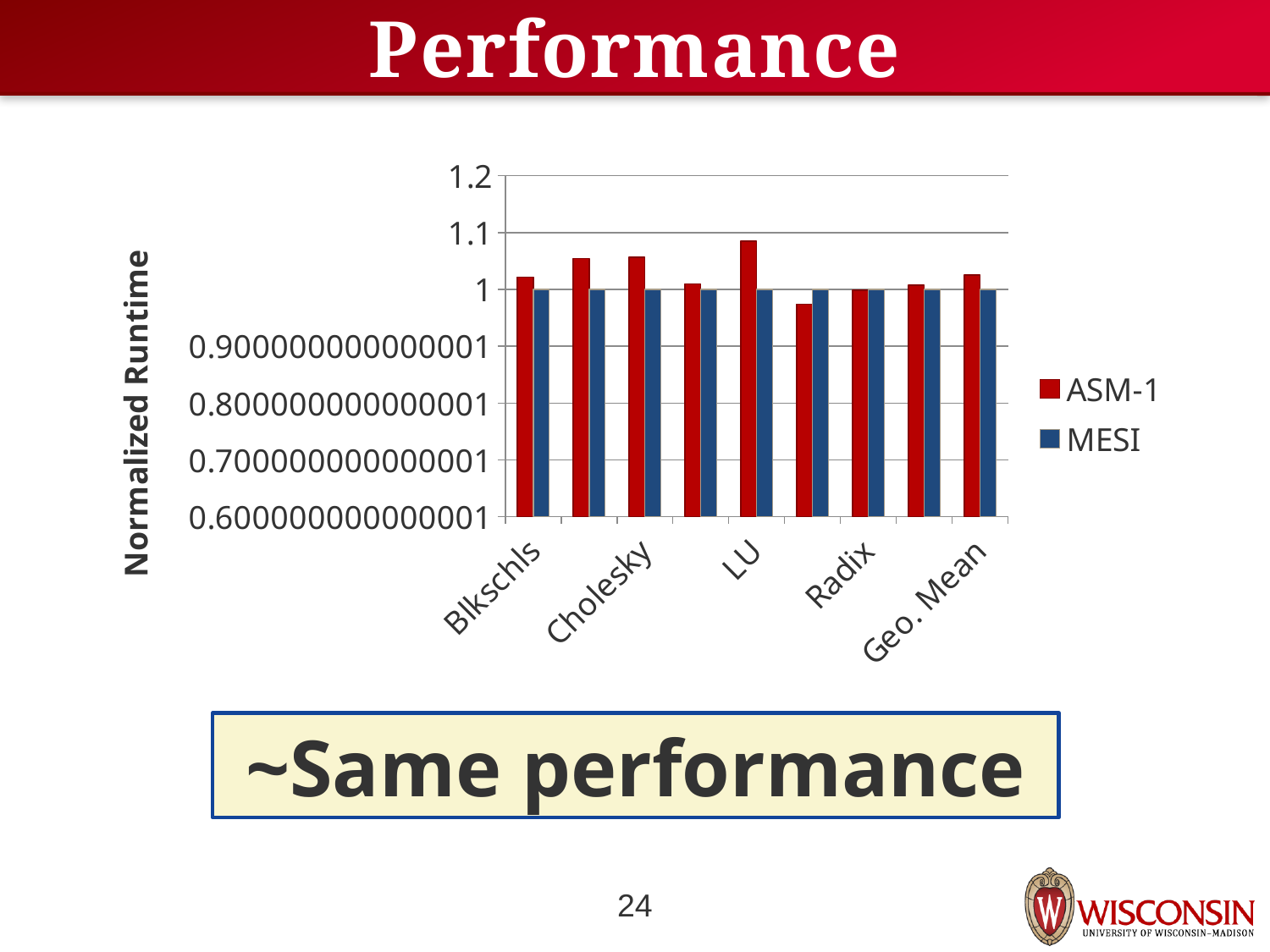
What is the title of the vertical axis? Normalized Runtime Is the ASM-1 value for LU greater or less than 1.1? less Among the labeled categories, which has the highest ASM-1 value? LU Is the ASM-1 value for LU greater or less than 1? greater For LU, which series has the larger value, ASM-1 or MESI? ASM-1 What is the MESI value for LU? 1 What are the two series named in the legend? ASM-1 and MESI Among the labeled categories, which has the lowest ASM-1 value? Radix What kind of chart is shown on the slide? bar chart How many series does the legend list? 2